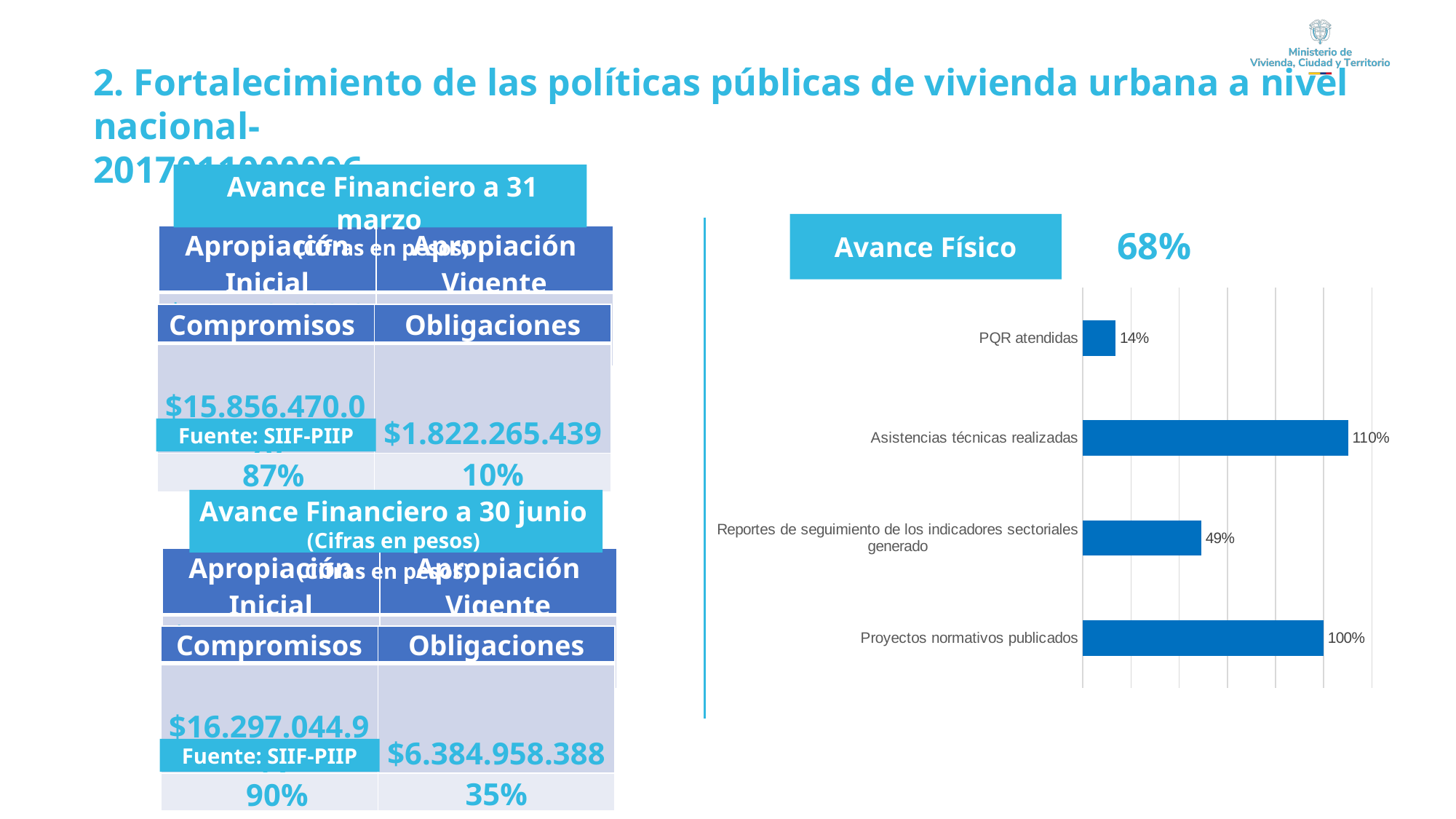
What is the value for Asistencias técnicas realizadas in the Avance Físico chart? 110% Which category has the highest value in the Avance Físico chart? Asistencias técnicas realizadas In the Avance Físico chart, what is the difference between Reportes de seguimiento de los indicadores sectoriales generado and PQR atendidas? 35% How many categories are shown in the Avance Físico chart? 4 In the Avance Físico chart, which is larger: Proyectos normativos publicados or Reportes de seguimiento de los indicadores sectoriales generado? Proyectos normativos publicados What is the value for Proyectos normativos publicados in the Avance Físico chart? 100% What is the value for PQR atendidas in the Avance Físico chart? 14% In the Avance Físico chart, what is the difference between Asistencias técnicas realizadas and Proyectos normativos publicados? 10% What is the value for Reportes de seguimiento de los indicadores sectoriales generado in the Avance Físico chart? 49% Which category has the lowest value in the Avance Físico chart? PQR atendidas What kind of chart is the Avance Físico chart? Bar chart What overall percentage is shown next to the Avance Físico heading? 68%